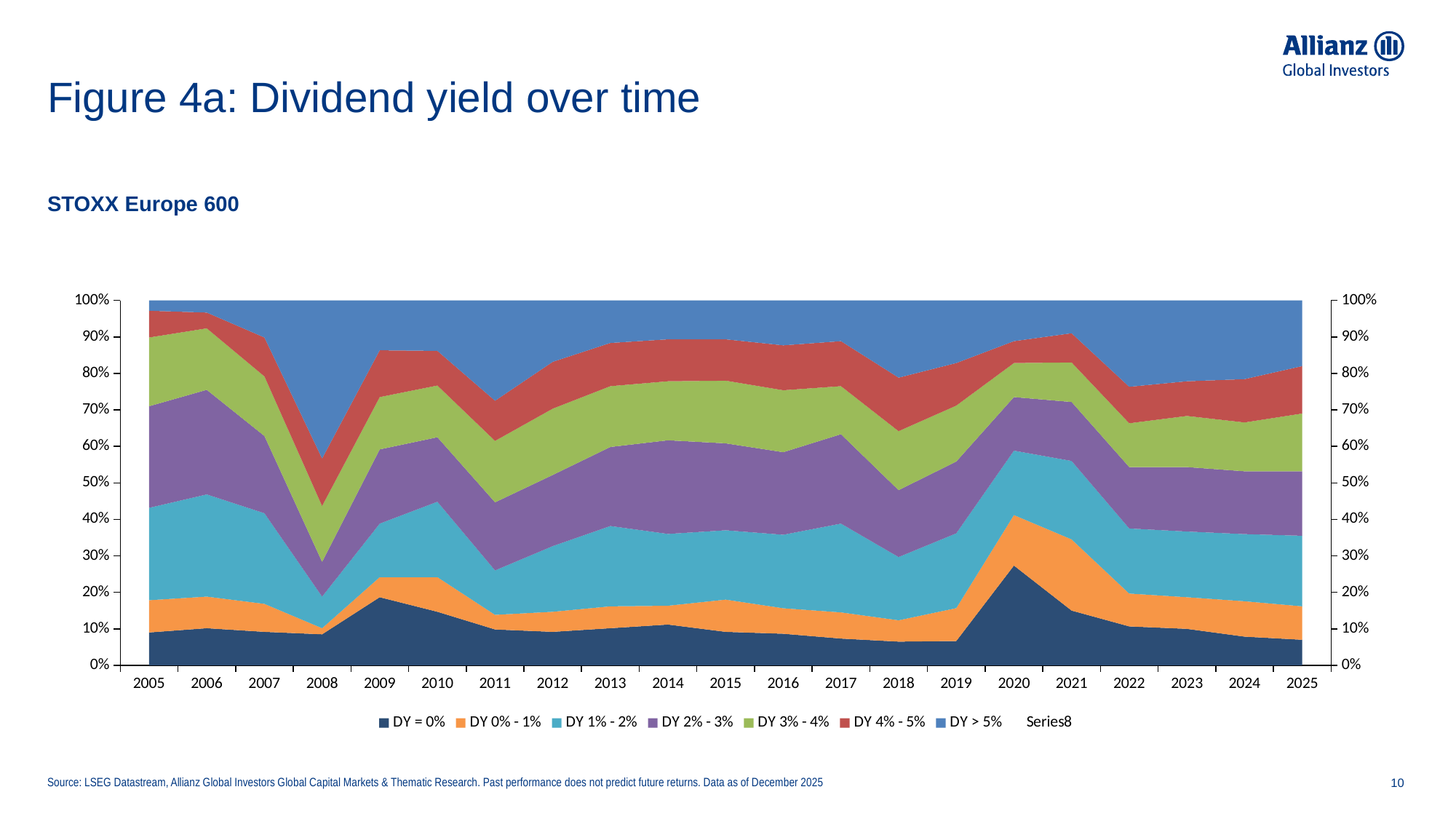
What kind of chart is shown on the slide? Stacked area chart How many years are shown along the x axis of the chart? 21 Which index does the chart cover, according to the subtitle? STOXX Europe 600 Does the share of DY = 0% rise or fall from 2020 to 2025? Fall Which year has the larger share of DY = 0%, 2020 or 2021? 2020 What is the first year shown on the x axis? 2005 In which year is the share of DY = 0% highest? 2020 Is the value for DY = 0% in 2020 greater or less than 20%? greater Is the value for DY = 0% in 2025 greater or less than 10%? less Is the value for DY = 0% in 2009 greater or less than 10%? greater How many entries does the chart's legend list? 8 What is the title of the figure on the slide? Figure 4a: Dividend yield over time